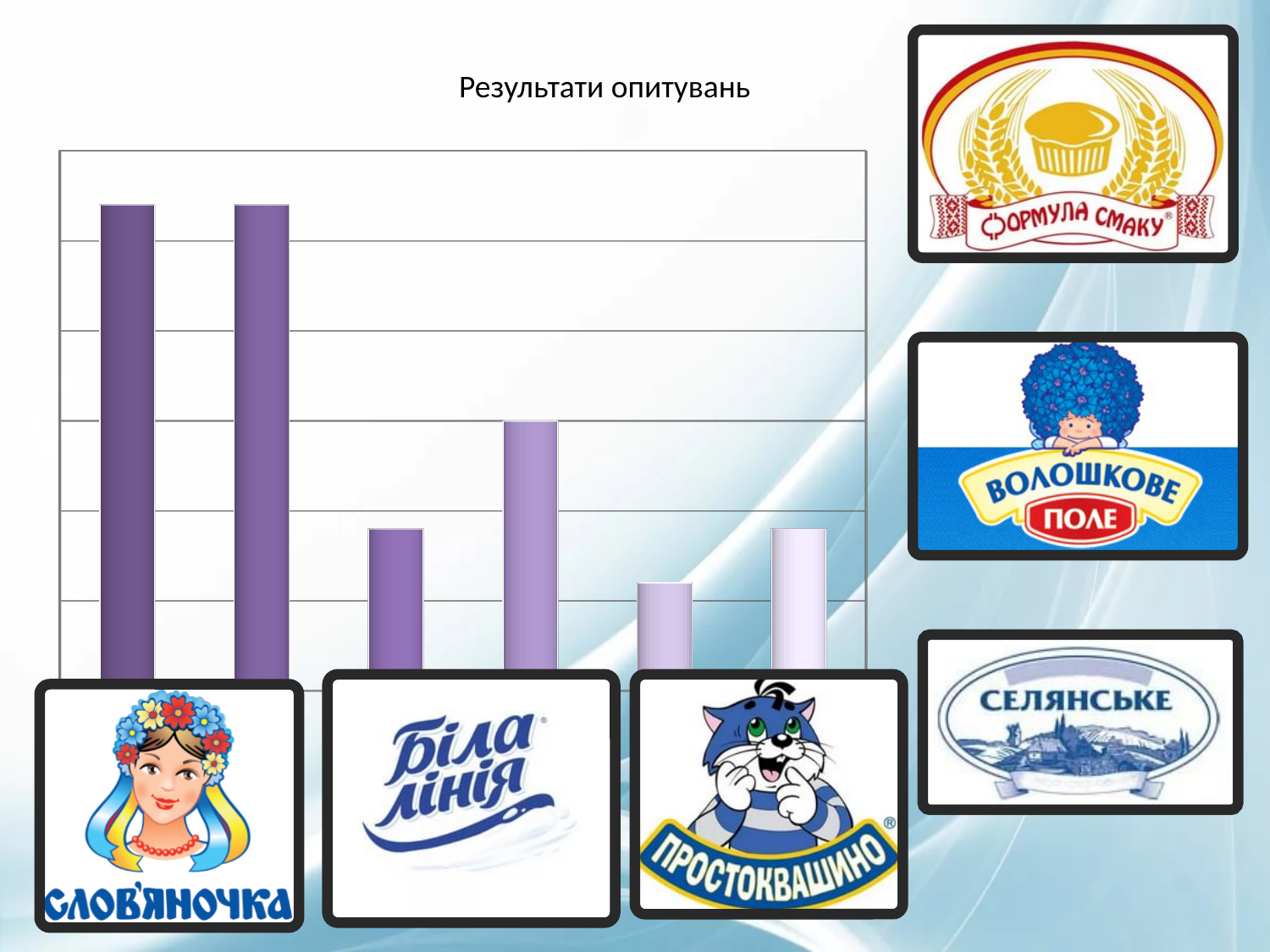
Which bar is the lowest in the chart, counting from the left? the fifth bar Does the chart show any data labels with exact values on the bars? No What is the title of the chart? Результати опитувань What kind of chart is shown on the slide? bar chart How many bars does the chart contain? 6 Which is taller, the fourth bar from the left or the sixth bar from the left? the fourth bar Which is taller, the third bar from the left or the fourth bar from the left? the fourth bar Which is taller, the third bar from the left or the fifth bar from the left? the third bar